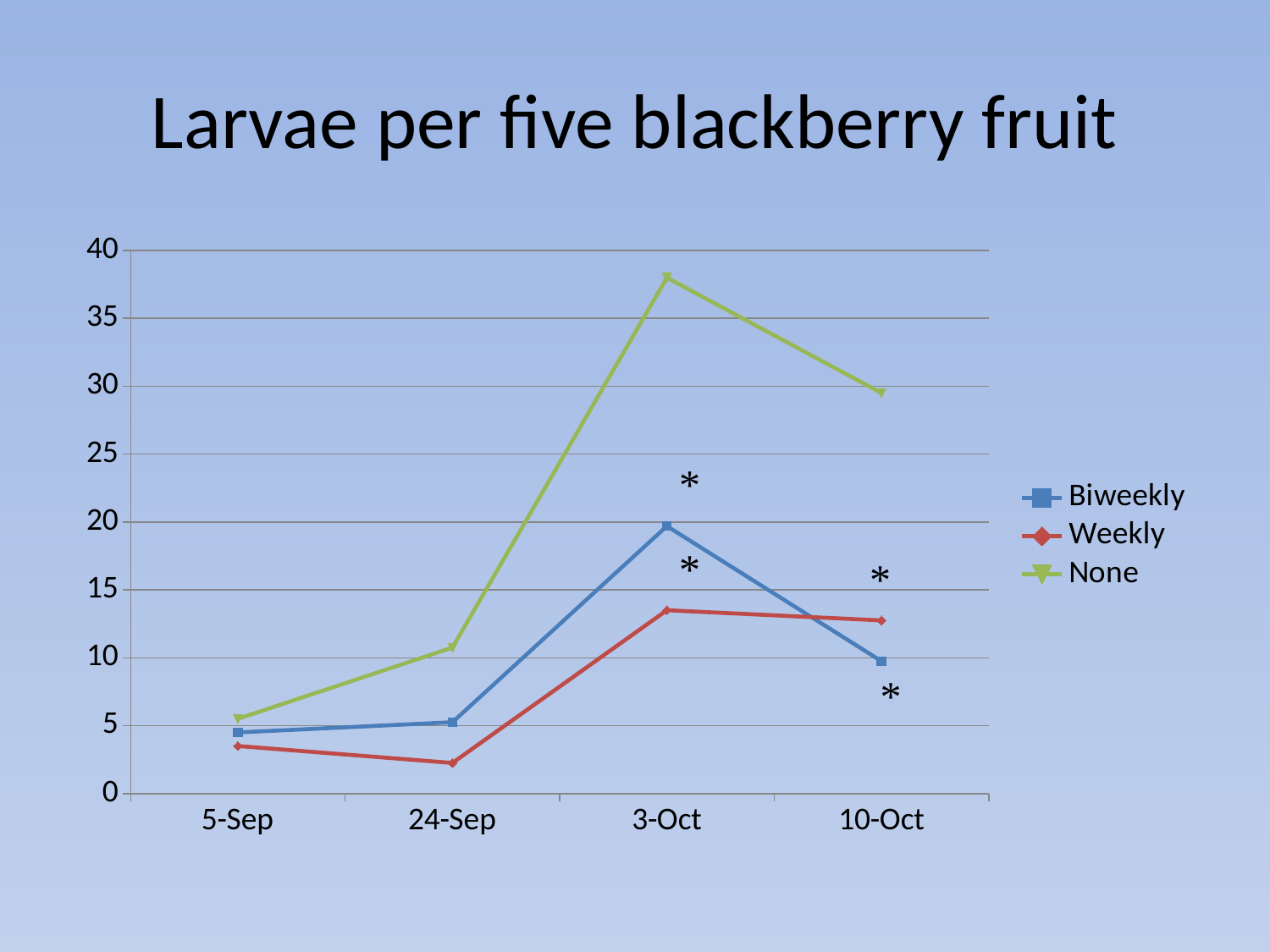
On 10-Oct, which is larger: the Biweekly value or the Weekly value? Weekly What kind of chart is shown on the slide? line chart Is the value for None on 3-Oct greater or less than 35? greater Is the value for None on 10-Oct greater or less than 25? greater Is the value for Biweekly on 3-Oct greater or less than 15? greater Which series has the highest value on 3-Oct? None What is the title of the chart? Larvae per five blackberry fruit How many series does the legend list? 3 Does the None series rise or fall from 3-Oct to 10-Oct? fall Which series has the lowest value on 24-Sep? Weekly How many dates are shown on the x axis? 4